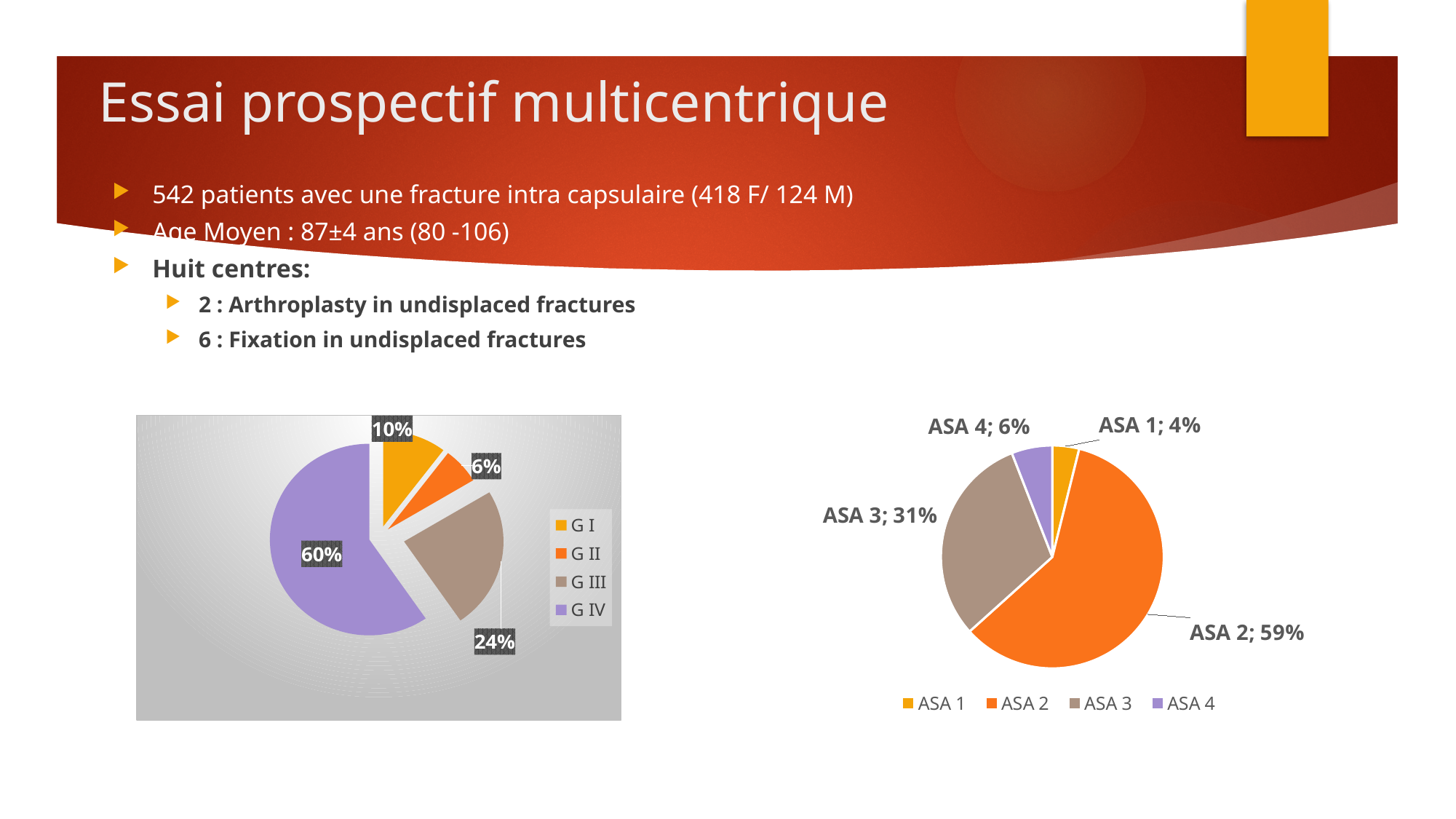
In the right pie chart (ASA), which category has the smallest share? ASA 1 In the right pie chart (ASA), what share does ASA 3 have? 31% In the right pie chart (ASA), what share does ASA 2 have? 59% In the right pie chart (ASA), what is the difference between the shares of ASA 2 and ASA 3? 28% In the left pie chart (G I to G IV), which category has the smallest share? G II What type of chart is the right chart (ASA)? Pie chart In the left pie chart (G I to G IV), what share does G III have? 24% In the left pie chart (G I to G IV), what is the difference between the shares of G I and G II? 4% In the right pie chart (ASA), which is larger, ASA 3 or ASA 4? ASA 3 In the left pie chart (G I to G IV), what share does G IV have? 60% In the left pie chart (G I to G IV), which category has the largest share? G IV In the left pie chart (G I to G IV), how many categories does the legend list? 4